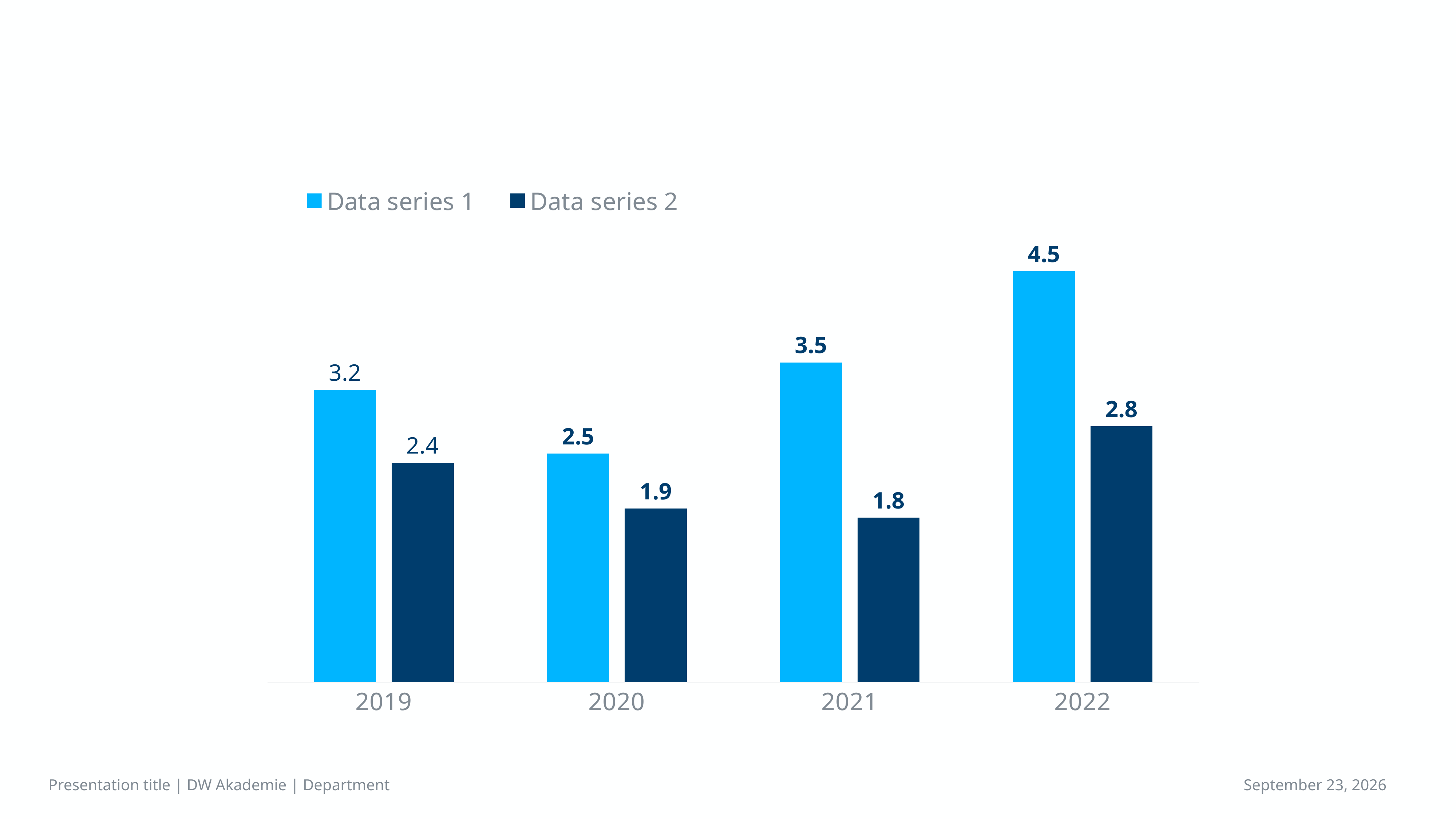
What is the value for Data series 1 in 2019? 3.2 How many data series does the legend list? 2 How many years are shown on the x axis? 4 Which is larger: Data series 2 in 2019 or Data series 2 in 2022? Data series 2 in 2022 What kind of chart is shown on the slide? Bar chart In which year is Data series 1 highest? 2022 In which year is Data series 2 lowest? 2021 What is the difference between Data series 1 and Data series 2 in 2022? 1.7 What is the value for Data series 2 in 2021? 1.8 What is the difference between Data series 1 in 2021 and Data series 1 in 2020? 1.0 What is the value for Data series 1 in 2022? 4.5 What is the value for Data series 2 in 2020? 1.9